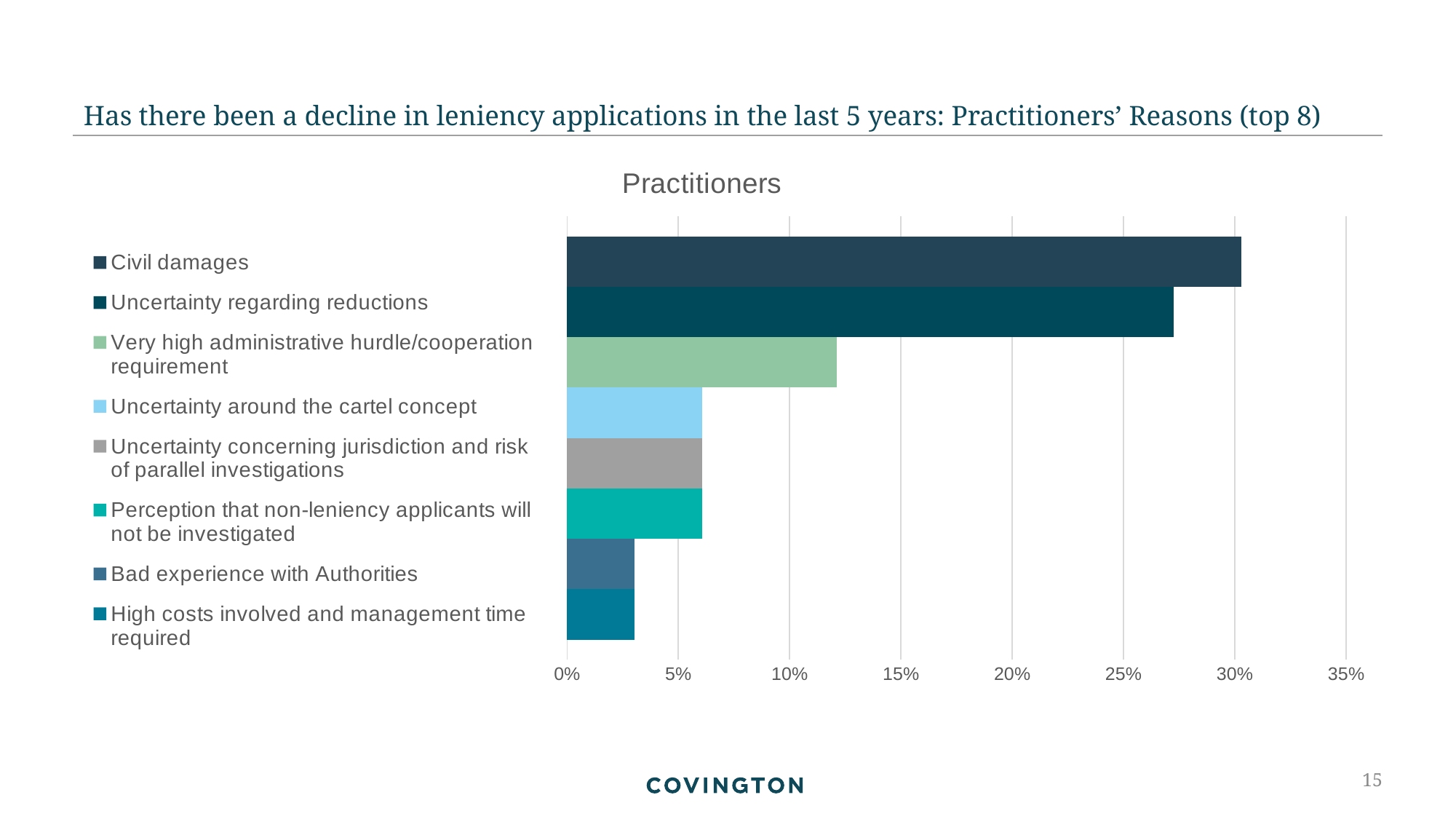
Is the value for Very high administrative hurdle/cooperation requirement greater or less than 10%? greater What is the title of the chart? Practitioners What kind of chart is shown on the slide? Bar chart Which reason has the highest value in the chart? Civil damages Is the value for Civil damages greater or less than 25%? greater Which is larger: the value for Civil damages or the value for Uncertainty regarding reductions? Civil damages Is the value for Bad experience with Authorities greater or less than 5%? less How many entries does the chart's legend list? 8 Which is larger: the value for Very high administrative hurdle/cooperation requirement or the value for Uncertainty around the cartel concept? Very high administrative hurdle/cooperation requirement How many bars are plotted in the chart? 8